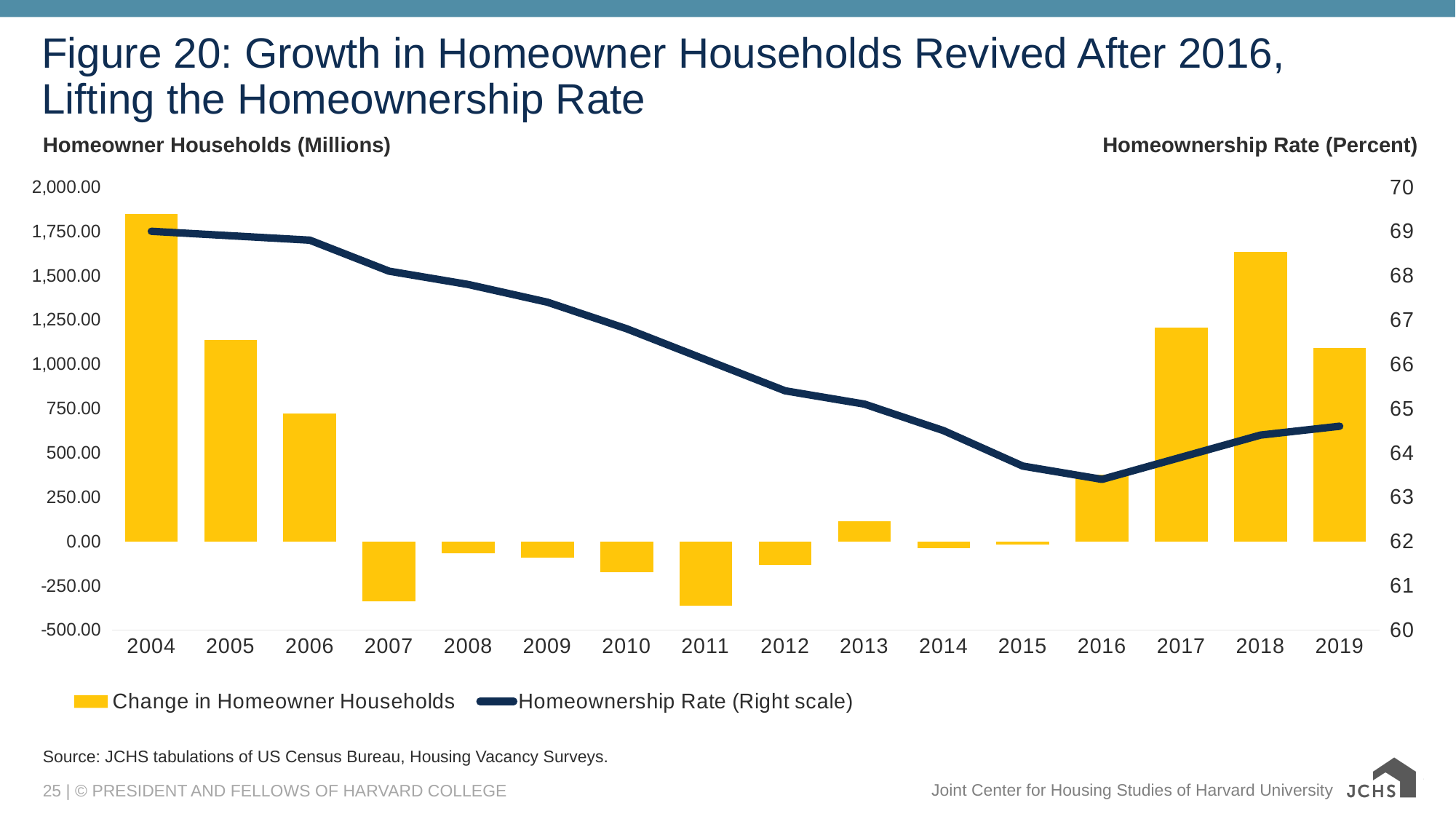
Is the Homeownership Rate for 2016 greater or less than 63? greater Is the Change in Homeowner Households bar for 2004 greater or less than 1,750.00? greater Is the Change in Homeowner Households bar for 2018 greater or less than 1,500.00? greater Does the Homeownership Rate line rise or fall from 2004 to 2016? Fall Which year has the larger Change in Homeowner Households bar, 2017 or 2018? 2018 How many years are shown on the x axis? 16 What kind of chart is shown on the slide? A combination bar and line chart How many series does the legend list? 2 What is the label of the right-hand axis? Homeownership Rate (Percent) Which year has the highest bar for Change in Homeowner Households? 2004